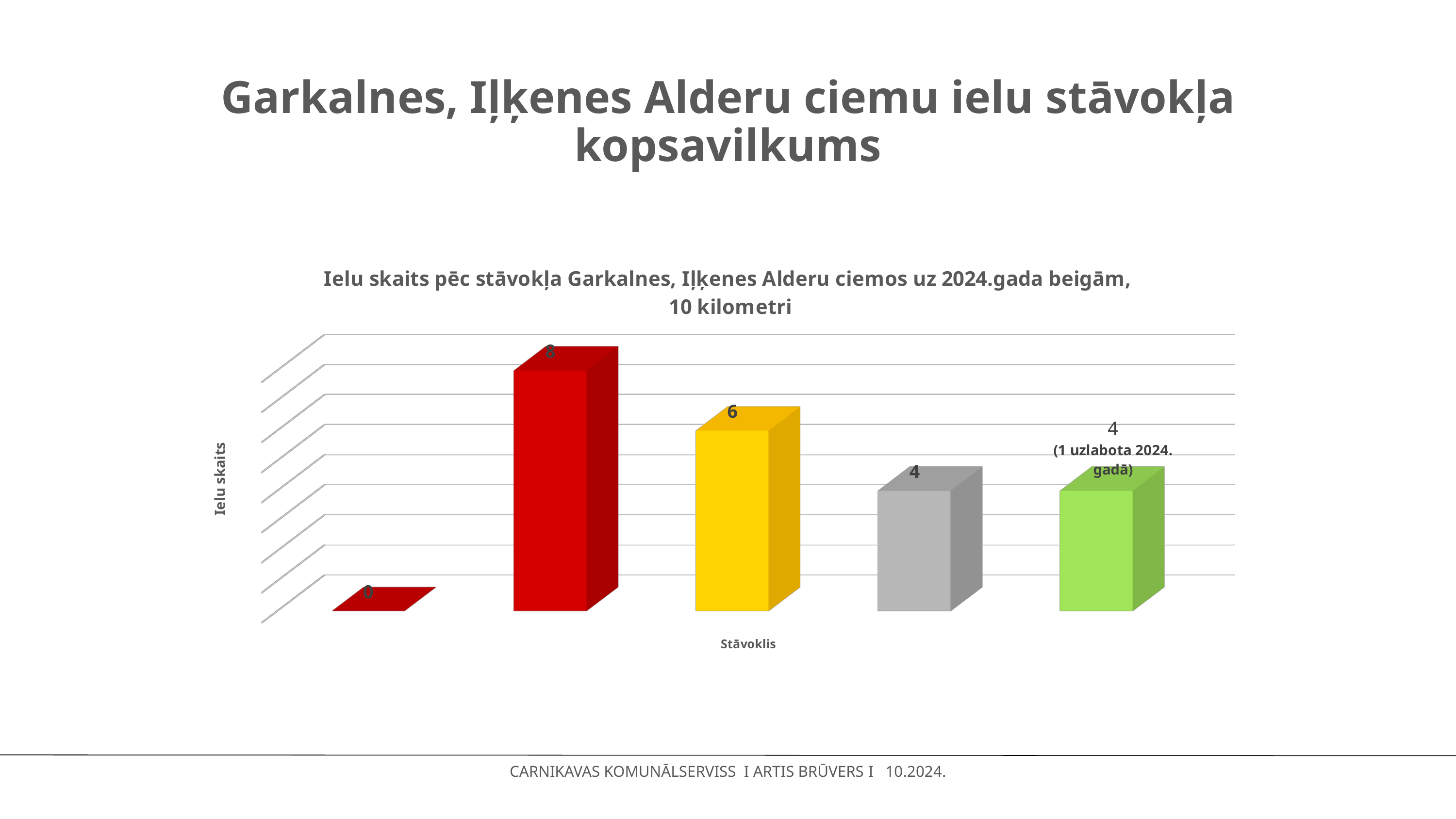
Which bar has the lowest value? the leftmost bar, 0 What is the difference between the value of the dark red bar and the yellow bar? 2 What is the value shown on the first (leftmost) bar? 0 What is the value shown on the green bar? 4 What is the value shown on the tallest bar (the dark red bar)? 8 How many bars are plotted in the chart? 5 Which bar has the highest value? the dark red bar (second from left), 8 What is the value shown on the grey bar? 4 Which is larger, the value of the yellow bar or the grey bar? the yellow bar What kind of chart is shown on the slide? bar chart What is the value shown on the yellow bar? 6 What is the title of the vertical axis? Ielu skaits